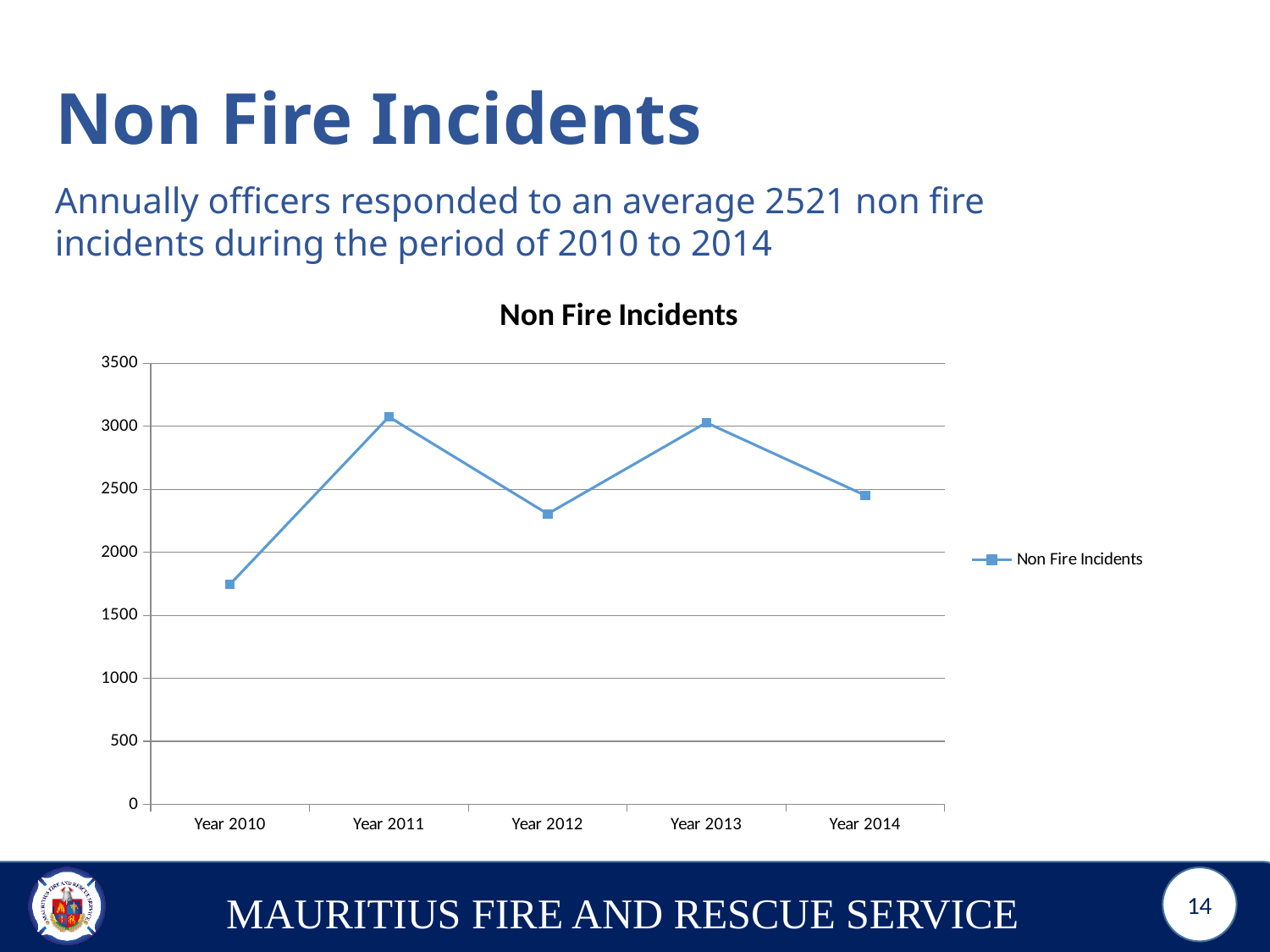
Which year has the lowest number of non fire incidents? Year 2010 Does the number of non fire incidents rise or fall from Year 2013 to Year 2014? fall Which is larger, the value for Year 2010 or the value for Year 2012? Year 2012 Is the value for Year 2014 greater or less than 2000? greater What kind of chart is shown on the slide? line chart What is the title of the chart? Non Fire Incidents How many series does the chart legend list? 1 How many years are plotted on the x axis of the chart? 5 Is the value for Year 2012 greater or less than 2500? less Is the value for Year 2010 greater or less than 2000? less